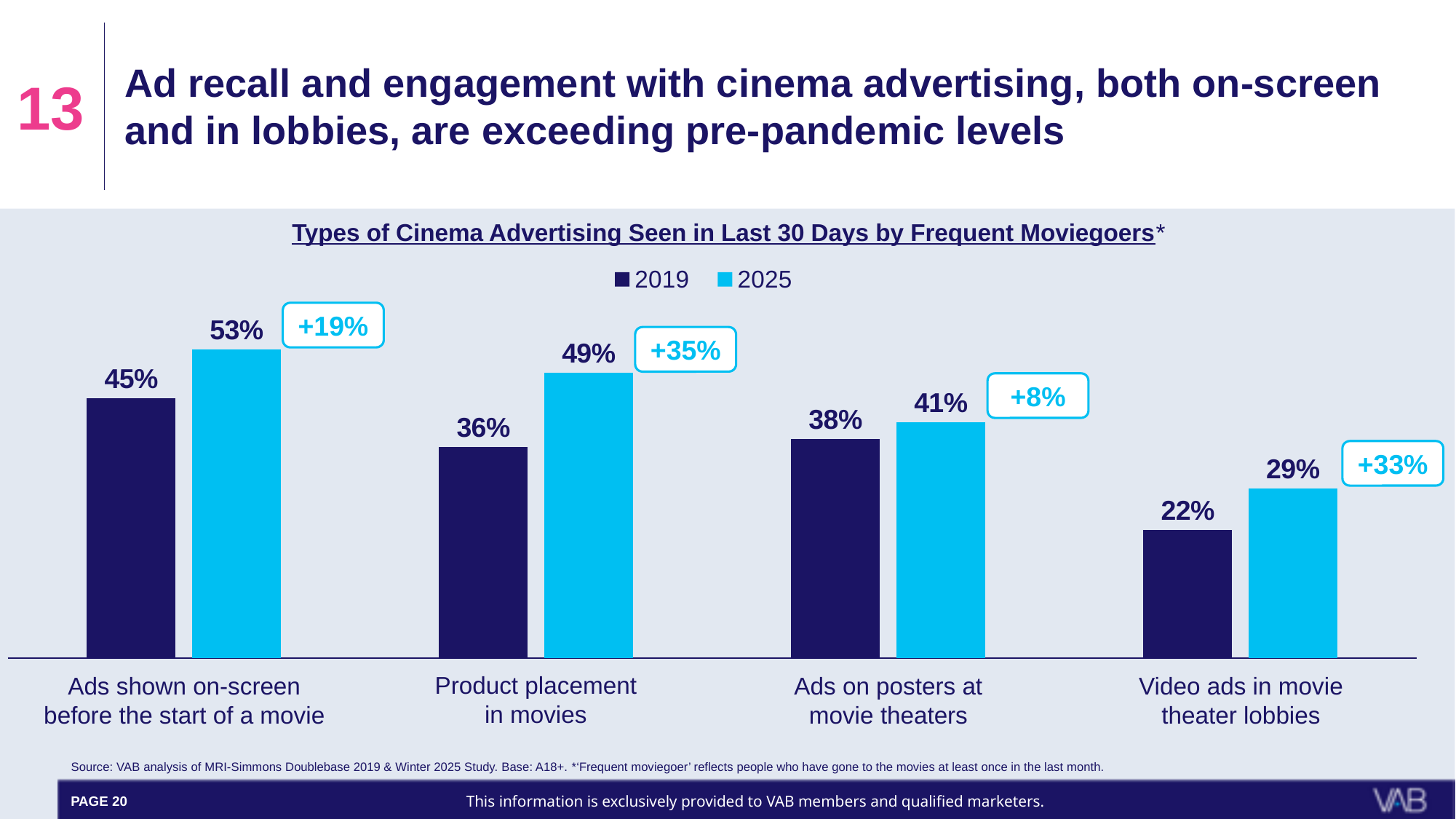
What is the 2019 value for Ads on posters at movie theaters? 38% What is the title of the chart? Types of Cinema Advertising Seen in Last 30 Days by Frequent Moviegoers* What is the 2019 value for Video ads in movie theater lobbies? 22% Which is larger: the 2019 value for Product placement in movies or the 2019 value for Ads on posters at movie theaters? Ads on posters at movie theaters What percentage change is shown in the callout box for Product placement in movies? +35% What is the 2025 value for Product placement in movies? 49% Which category has the lowest 2019 value? Video ads in movie theater lobbies Which category has the highest 2025 value? Ads shown on-screen before the start of a movie What kind of chart is shown on the slide? Bar chart How many series does the legend list? 2 What is the difference between the 2025 and 2019 values for Ads shown on-screen before the start of a movie? 8 percentage points How many categories are shown on the x axis? 4